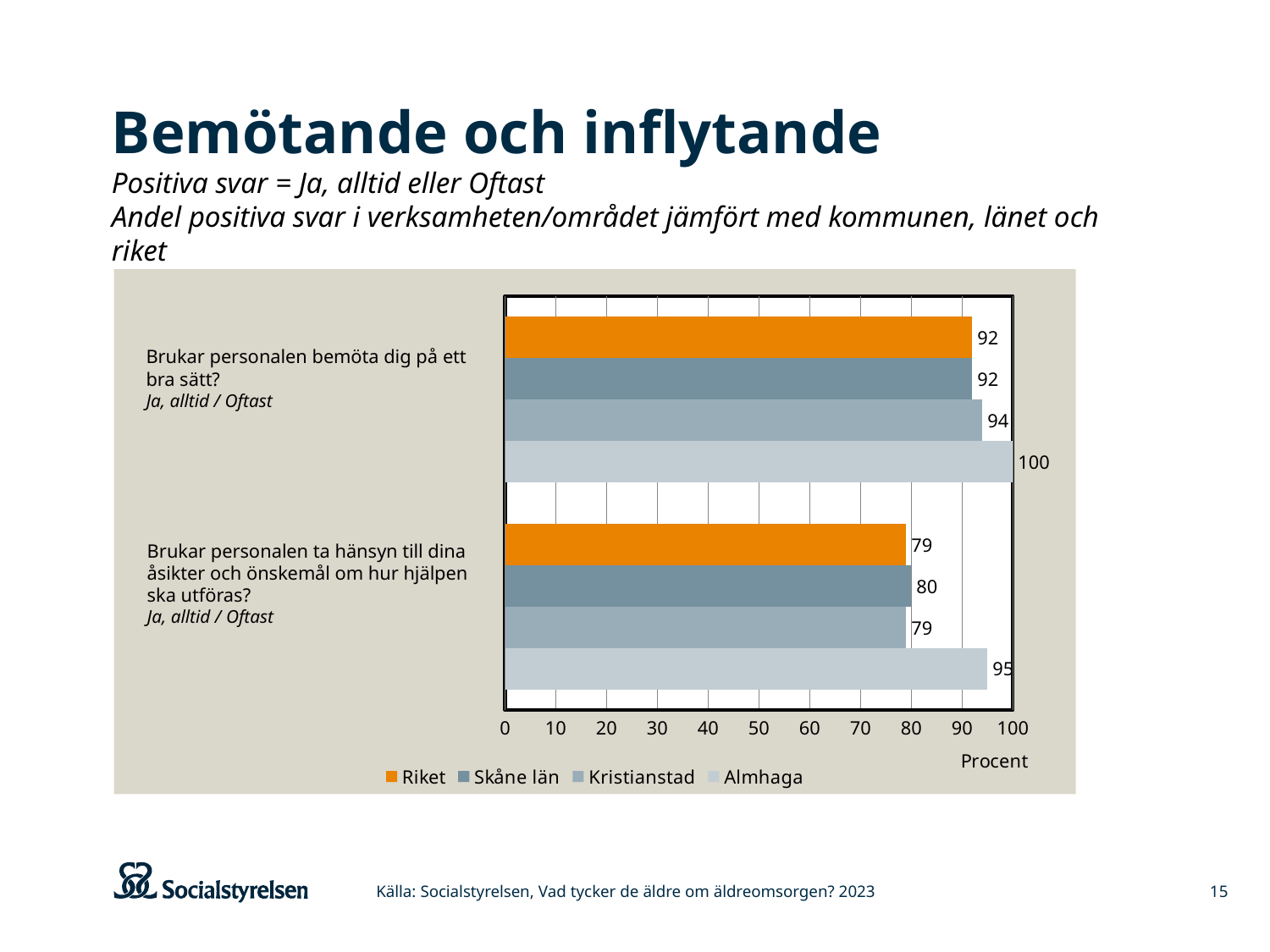
Which is larger for Almhaga: the value for "Brukar personalen bemöta dig på ett bra sätt?" or for "Brukar personalen ta hänsyn till dina åsikter och önskemål om hur hjälpen ska utföras?"? Brukar personalen bemöta dig på ett bra sätt? Which series has the highest value on the question "Brukar personalen ta hänsyn till dina åsikter och önskemål om hur hjälpen ska utföras?"? Almhaga What is the value for Skåne län on the question "Brukar personalen ta hänsyn till dina åsikter och önskemål om hur hjälpen ska utföras?"? 80 Is the value for Riket on the question "Brukar personalen ta hänsyn till dina åsikter och önskemål om hur hjälpen ska utföras?" greater or less than 80? less What kind of chart is shown on the slide? Bar chart How many questions (categories) are shown on the chart? 2 What is the difference between Almhaga and Kristianstad on the question "Brukar personalen bemöta dig på ett bra sätt?"? 6 What is the value for Riket on the question "Brukar personalen ta hänsyn till dina åsikter och önskemål om hur hjälpen ska utföras?"? 79 What is the value for Almhaga on the question "Brukar personalen bemöta dig på ett bra sätt?"? 100 How many series does the legend list? 4 What is the value for Kristianstad on the question "Brukar personalen bemöta dig på ett bra sätt?"? 94 What is the difference between Almhaga and Riket on the question "Brukar personalen ta hänsyn till dina åsikter och önskemål om hur hjälpen ska utföras?"? 16